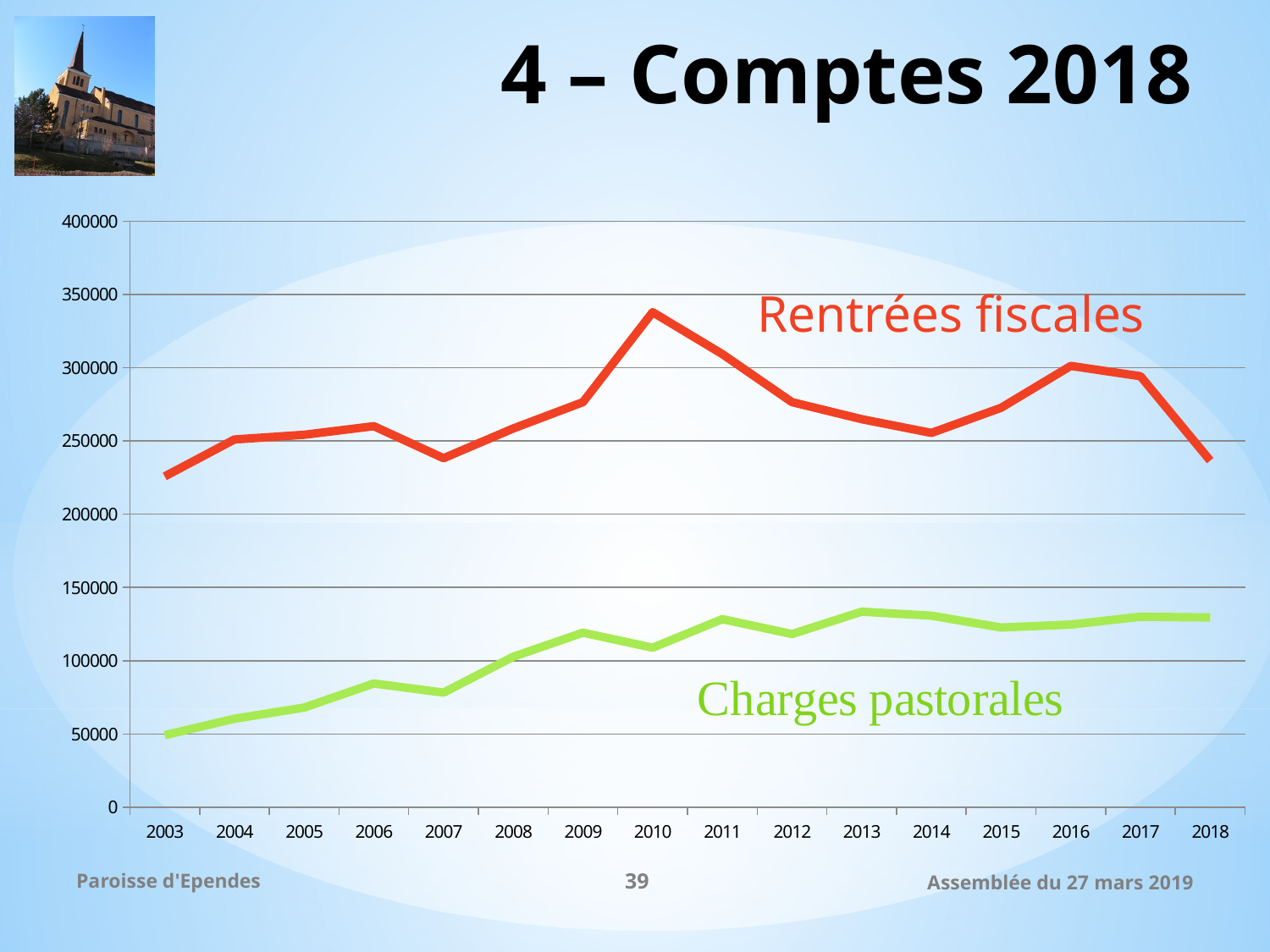
In which year do the Rentrées fiscales reach their highest value? 2010 How many series are plotted on the chart? 2 Which series has the larger value in 2010, Rentrées fiscales or Charges pastorales? Rentrées fiscales Is the value of Rentrées fiscales in 2010 greater or less than 300000? greater Is the value of Rentrées fiscales in 2018 greater or less than 250000? less What colour is the Rentrées fiscales line? Red In which year are the Charges pastorales at their lowest? 2003 What kind of chart is shown on the slide? Line chart Is the value of Charges pastorales in 2018 greater or less than 100000? greater Do the Charges pastorales generally rise or fall from 2003 to 2018? Rise How many years are shown on the x axis of the chart? 16